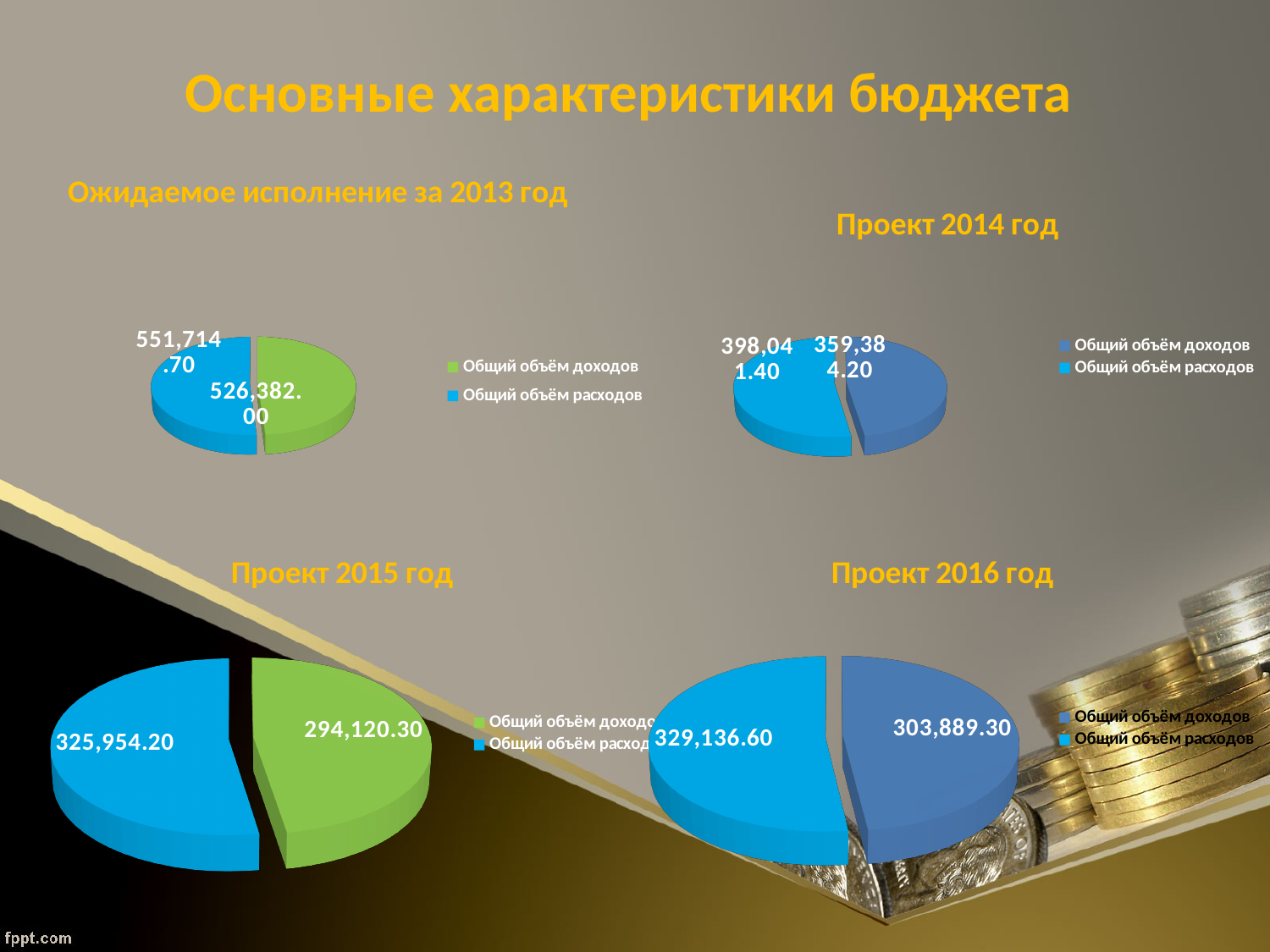
In the chart 'Проект 2015 год', what is the difference between Общий объём расходов and Общий объём доходов? 31,833.90 In the chart 'Ожидаемое исполнение за 2013 год', what is the value for Общий объём доходов? 526,382.00 In the chart 'Ожидаемое исполнение за 2013 год', what is the value for Общий объём расходов? 551,714.70 In the chart 'Проект 2016 год', what is the value for Общий объём доходов? 303,889.30 In the chart 'Проект 2016 год', what is the difference between Общий объём расходов and Общий объём доходов? 25,247.30 In the chart 'Проект 2015 год', which category has the larger value? Общий объём расходов What kind of chart is used for 'Проект 2014 год'? Pie chart In the chart 'Проект 2016 год', which category has the smaller value? Общий объём доходов How many entries does the legend of the chart 'Проект 2015 год' list? 2 In the chart 'Проект 2016 год', what is the value for Общий объём расходов? 329,136.60 In the chart 'Ожидаемое исполнение за 2013 год', which is larger: Общий объём доходов or Общий объём расходов? Общий объём расходов In the chart 'Проект 2015 год', what is the value for Общий объём доходов? 294,120.30